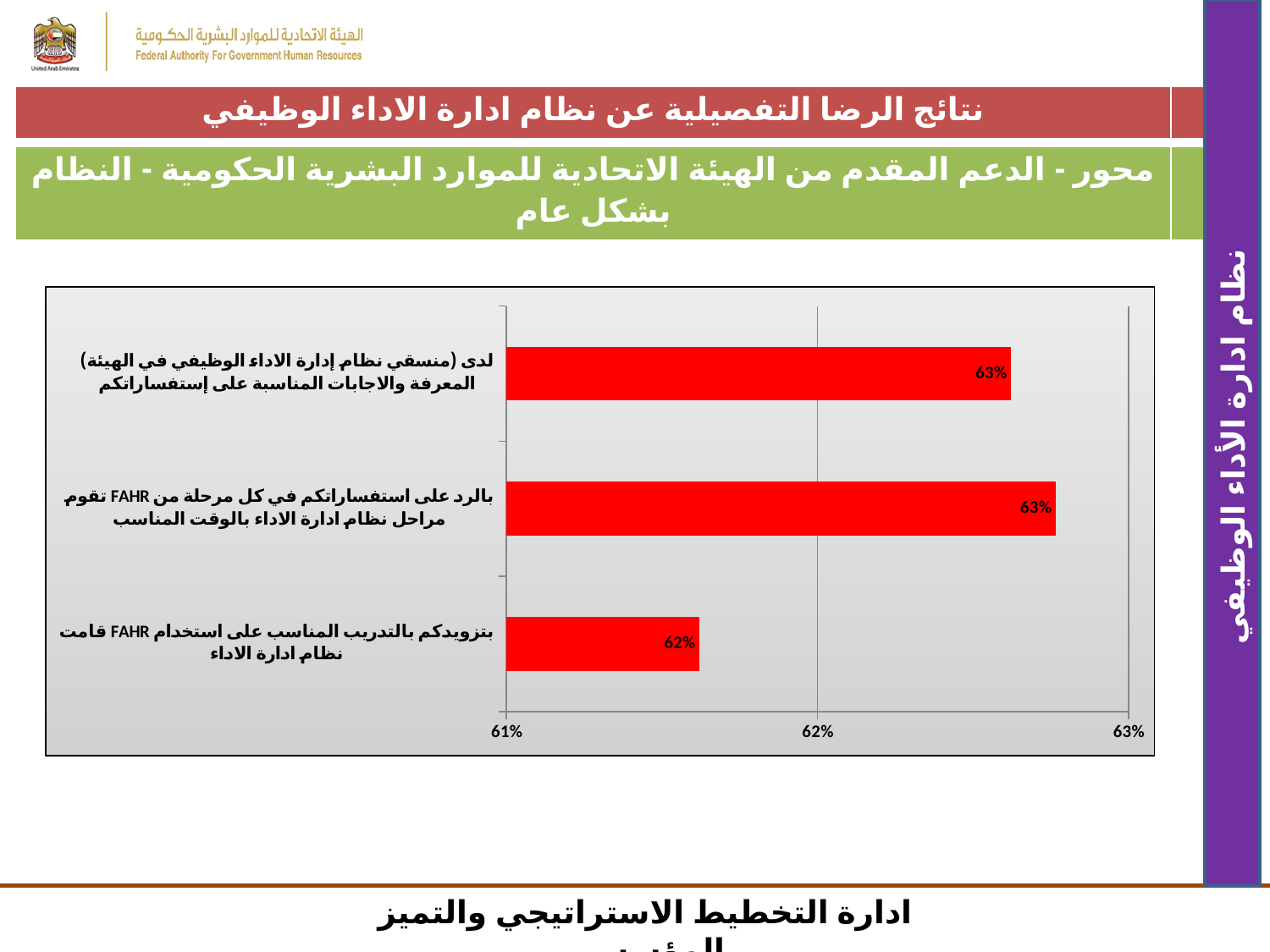
What is the value for the category "تقوم FAHR بالرد على استفساراتكم في كل مرحلة من مراحل نظام ادارة الاداء بالوقت المناسب"? 63% Is the value for "قامت FAHR بتزويدكم بالتدريب المناسب على استخدام نظام ادارة الاداء" greater or less than 63%? less What is the value for the category "لدى (منسقي نظام إدارة الاداء الوظيفي في الهيئة) المعرفة والاجابات المناسبة على إستفساراتكم"? 63% What is the lowest value printed on the horizontal axis of the chart? 61% How many categories (bars) does the chart show? 3 What colour are the bars in the chart? red Which category has the lowest value? قامت FAHR بتزويدكم بالتدريب المناسب على استخدام نظام ادارة الاداء Which is larger: the value for "تقوم FAHR بالرد على استفساراتكم في كل مرحلة من مراحل نظام ادارة الاداء بالوقت المناسب" or the value for "قامت FAHR بتزويدكم بالتدريب المناسب على استخدام نظام ادارة الاداء"? تقوم FAHR بالرد على استفساراتكم في كل مرحلة من مراحل نظام ادارة الاداء بالوقت المناسب What is the difference between the value for "لدى (منسقي نظام إدارة الاداء الوظيفي في الهيئة) المعرفة والاجابات المناسبة على إستفساراتكم" and the value for "قامت FAHR بتزويدكم بالتدريب المناسب على استخدام نظام ادارة الاداء"? 1% Is the value for "تقوم FAHR بالرد على استفساراتكم في كل مرحلة من مراحل نظام ادارة الاداء بالوقت المناسب" greater or less than 62%? greater What kind of chart is shown on the slide? bar chart What is the value for the category "قامت FAHR بتزويدكم بالتدريب المناسب على استخدام نظام ادارة الاداء"? 62%